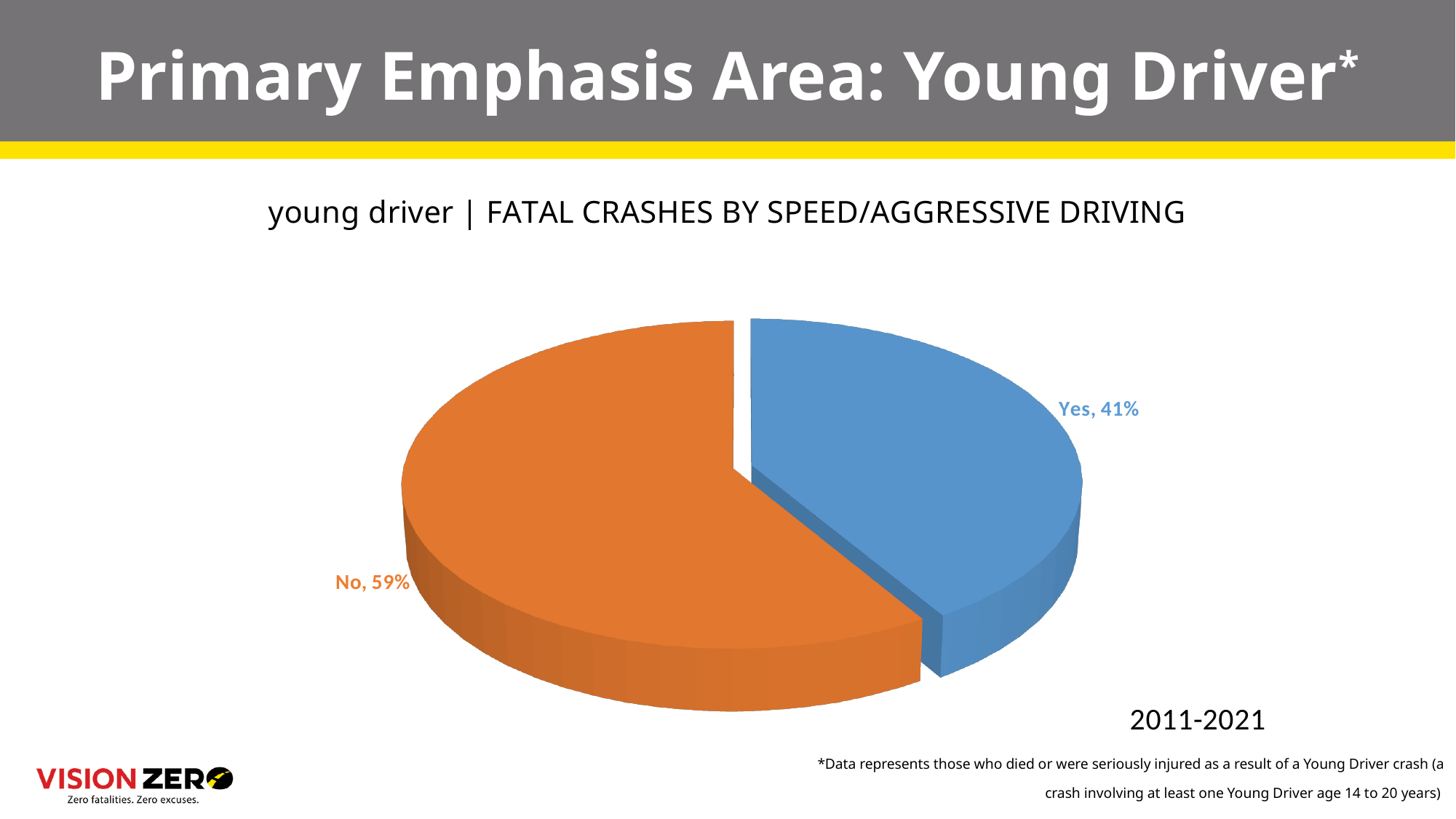
What colour is the No slice of the pie chart? orange What is the difference in percentage points between the No and Yes slices? 18 How many slices does the pie chart have? 2 What share of the pie does the Yes slice represent? 41% What percentage of young driver fatal crashes did not involve speed/aggressive driving (No)? 59% What percentage of young driver fatal crashes involved speed/aggressive driving (Yes)? 41% Which category has the smaller share of the pie? Yes What is the title of the chart? young driver | FATAL CRASHES BY SPEED/AGGRESSIVE DRIVING Which category has the larger share of the pie, Yes or No? No Is the value for No greater or less than 50%? greater What type of chart is shown on the slide? pie chart Is the Yes slice larger or smaller than the No slice? smaller